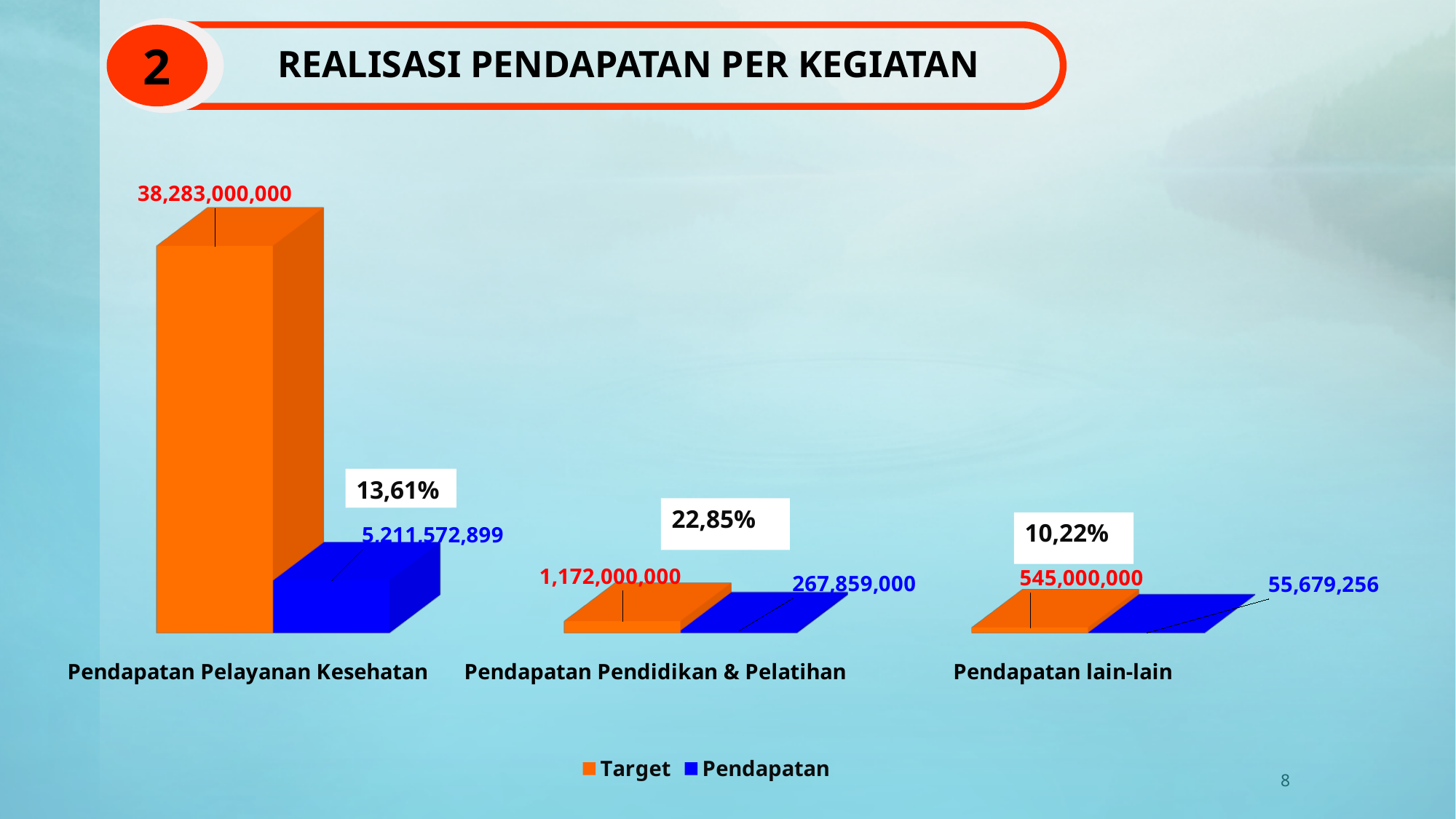
How many categories are shown on the x axis? 3 What is the Pendapatan value for Pendapatan lain-lain? 55,679,256 Which category has the highest Target value? Pendapatan Pelayanan Kesehatan What is the Target value for Pendapatan Pelayanan Kesehatan? 38,283,000,000 Which category has the lowest Pendapatan value? Pendapatan lain-lain Which is larger for Pendapatan lain-lain: the Target value or the Pendapatan value? Target What kind of chart is shown on the slide? Bar chart How many series does the legend list? 2 What is the Target value for Pendapatan lain-lain? 545,000,000 What is the difference between the Target and Pendapatan values for Pendapatan Pendidikan & Pelatihan? 904,141,000 What is the Pendapatan value for Pendapatan Pendidikan & Pelatihan? 267,859,000 What percentage is shown above the bars for Pendapatan Pendidikan & Pelatihan? 22,85%